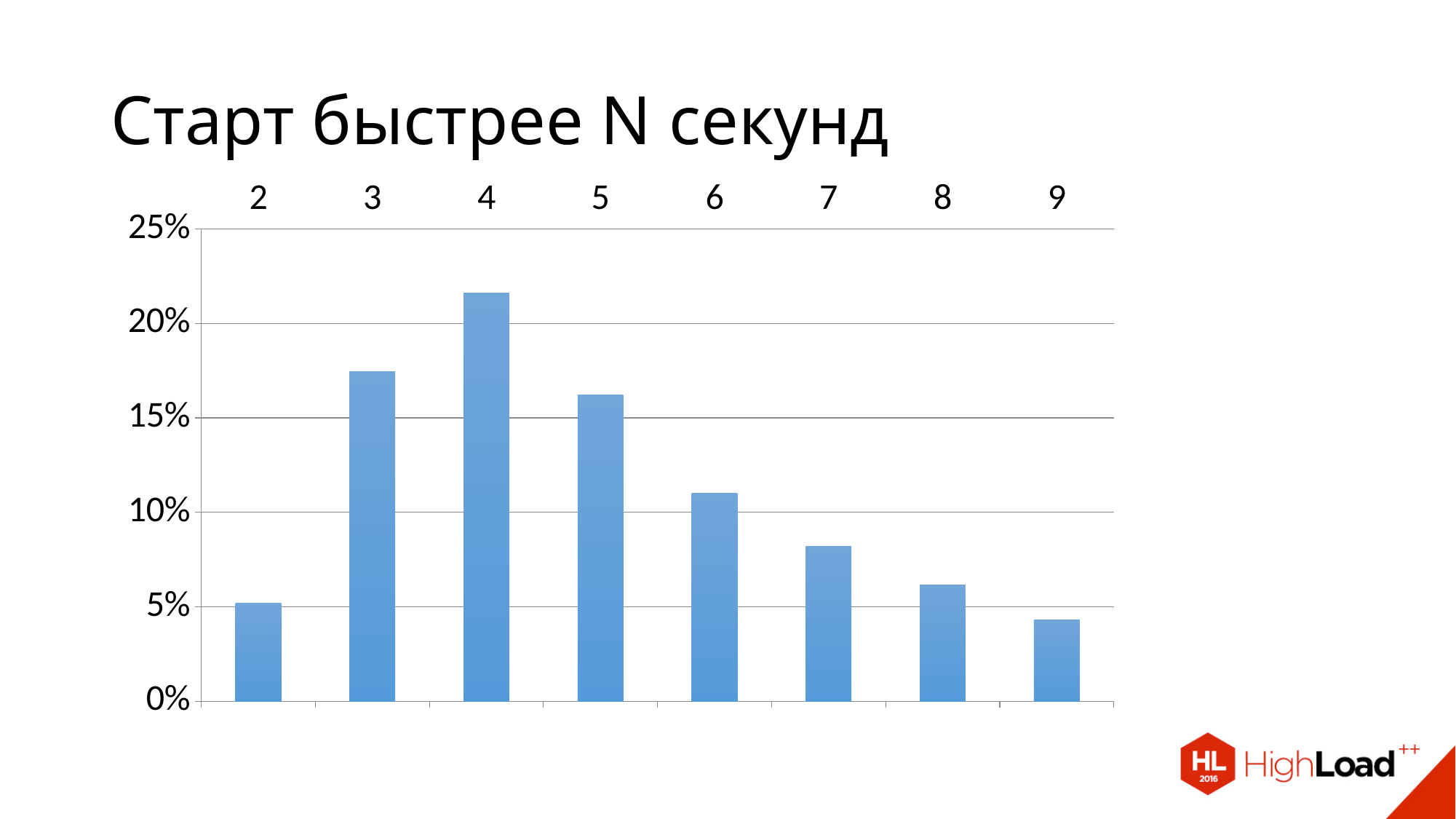
Which is larger, the value for category 7 or the value for category 8? 7 Which is larger, the value for category 3 or the value for category 6? 3 Do the values rise or fall from category 4 to category 9? fall Which category has the highest bar? 4 Is the value for category 3 greater or less than 15%? greater Is the value for category 9 greater or less than 5%? less How many bars are plotted in the chart? 8 Which category has the lowest bar? 9 What kind of chart is shown on the slide? bar chart Is the value for category 4 greater or less than 20%? greater What is the title of the chart? Старт быстрее N секунд